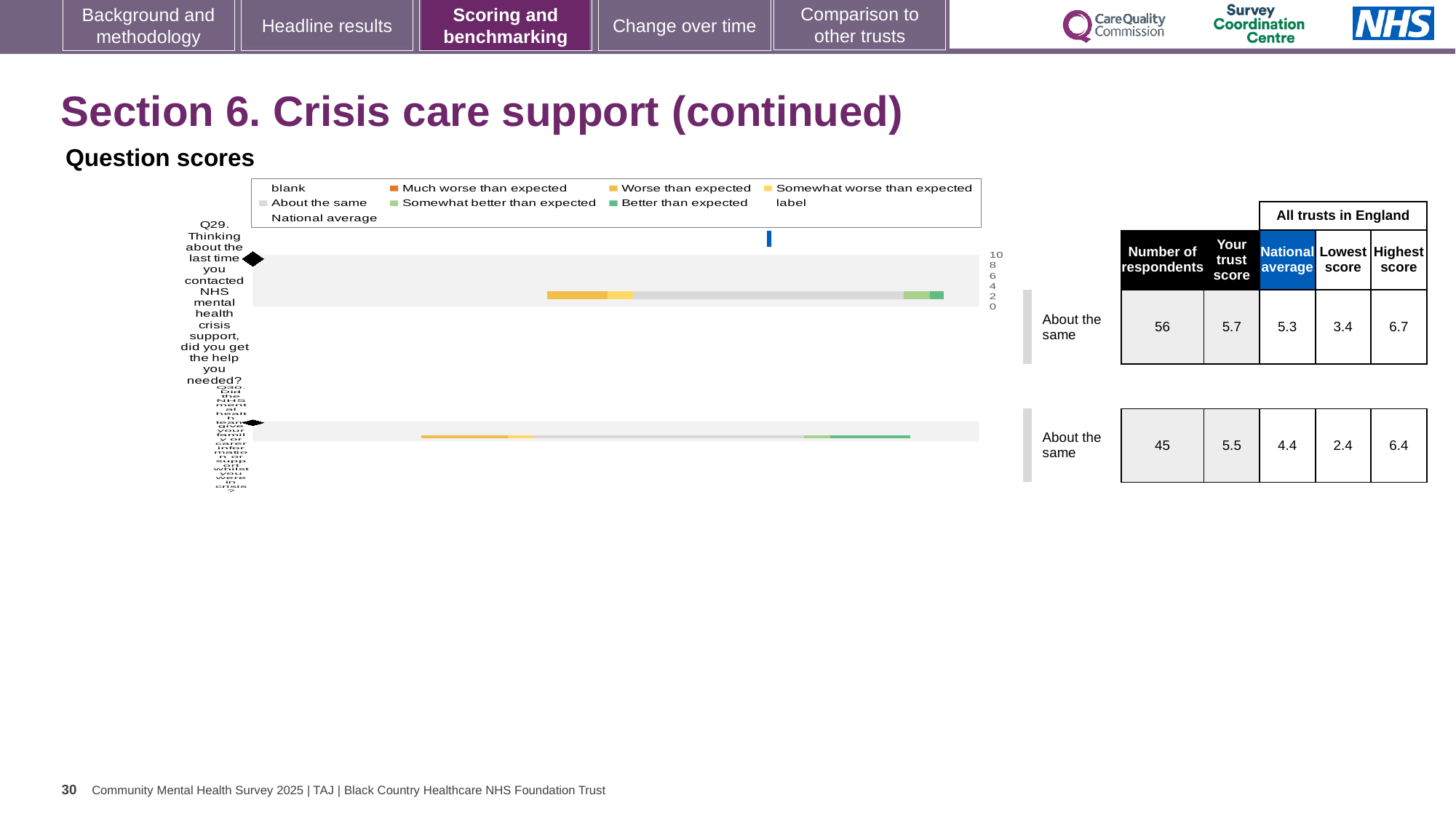
How many questions are plotted in the question scores chart? 2 What is the highest score across all trusts in England for Q30? 6.4 What is the trust score for Q30 (Did the NHS mental health team give your family or carer information or support whilst you were in crisis?)? 5.5 What is the national average score for Q29? 5.3 What is the national average score for Q30? 4.4 What is the trust score for Q29 (Thinking about the last time you contacted NHS mental health crisis support, did you get the help you needed?)? 5.7 What is the lowest score across all trusts in England for Q29? 3.4 What kind of chart is used to show the question scores on this slide? bar chart What is the difference between the trust score and the national average for Q29? 0.4 Which is larger for Q30: the trust score or the national average? the trust score How many respondents answered Q29? 56 Which benchmark category is the trust placed in for Q29? About the same